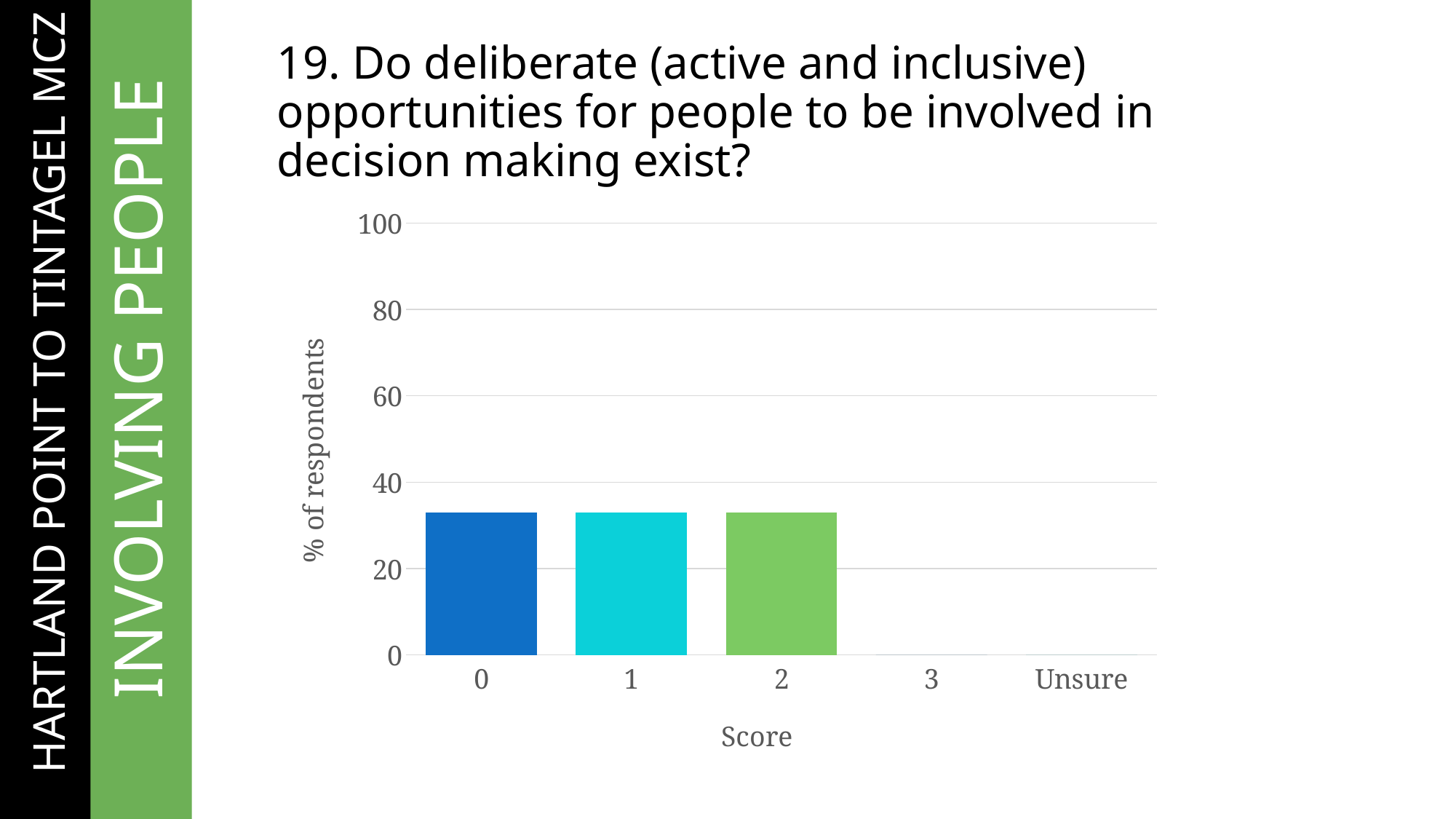
Is the value for score 2 greater or less than 40? less How many score categories have a visible bar? 3 How many score categories are shown on the x axis? 5 Is the value for score 3 greater or less than 20? less What is the label of the y axis? % of respondents Is the value for score 0 greater or less than 40? less Which is larger, the value for score 0 or the value for Unsure? score 0 Which is larger, the value for score 2 or the value for score 3? score 2 What is the label of the x axis? Score What kind of chart is shown on the slide? bar chart